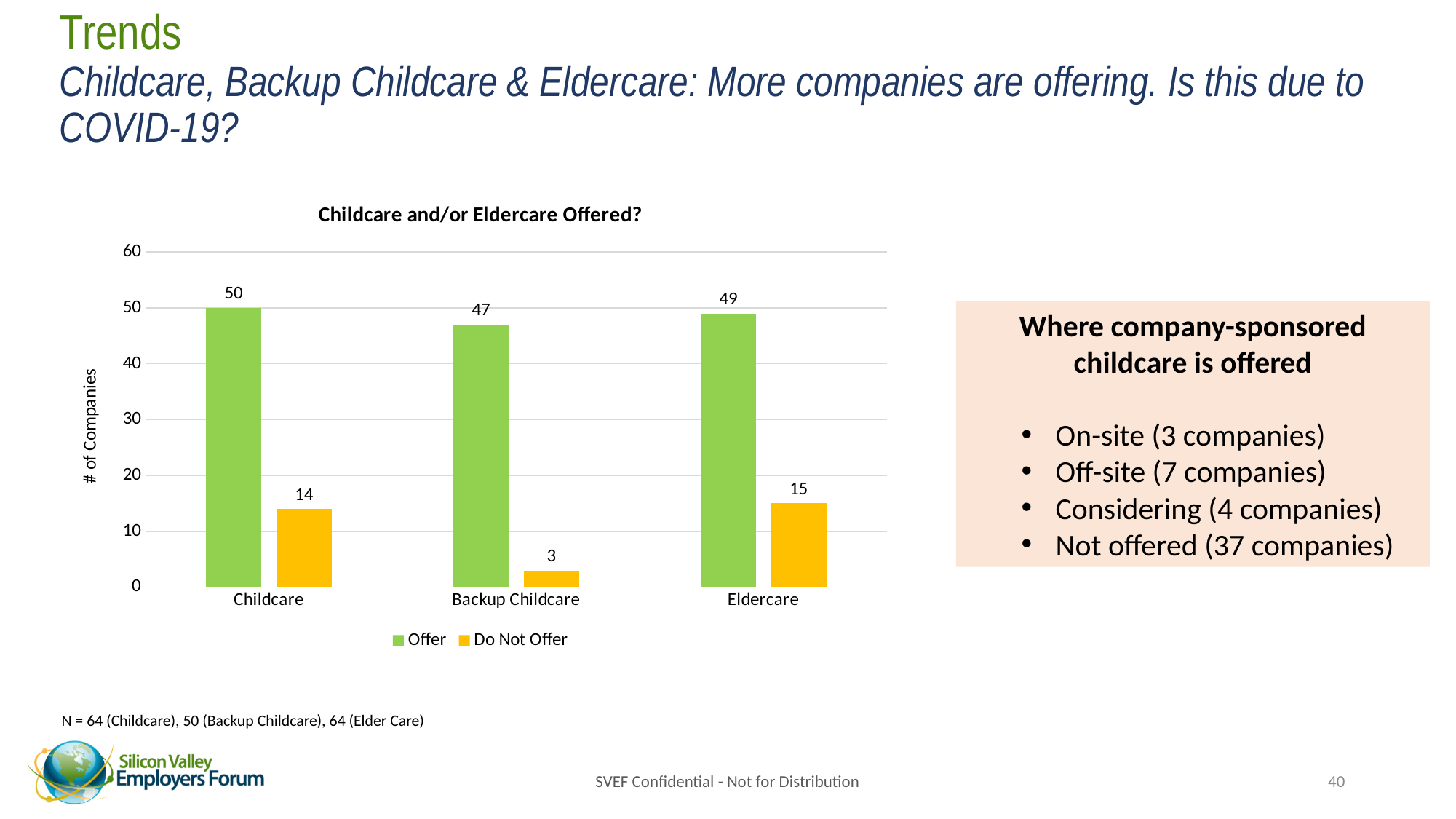
Which category has the highest Offer value? Childcare How many series does the legend list? 2 How many categories are shown on the x axis? 3 What is the difference between the Offer and Do Not Offer values for Childcare? 36 What is the title of the chart? Childcare and/or Eldercare Offered? What is the value for Do Not Offer in the Eldercare category? 15 What kind of chart is shown on the slide? bar chart Which is larger: the Do Not Offer value for Childcare or for Eldercare? Eldercare How many companies do not offer Backup Childcare? 3 Which category has the lowest Do Not Offer value? Backup Childcare Is the Offer value for Backup Childcare greater or less than 40? greater How many companies offer Childcare? 50